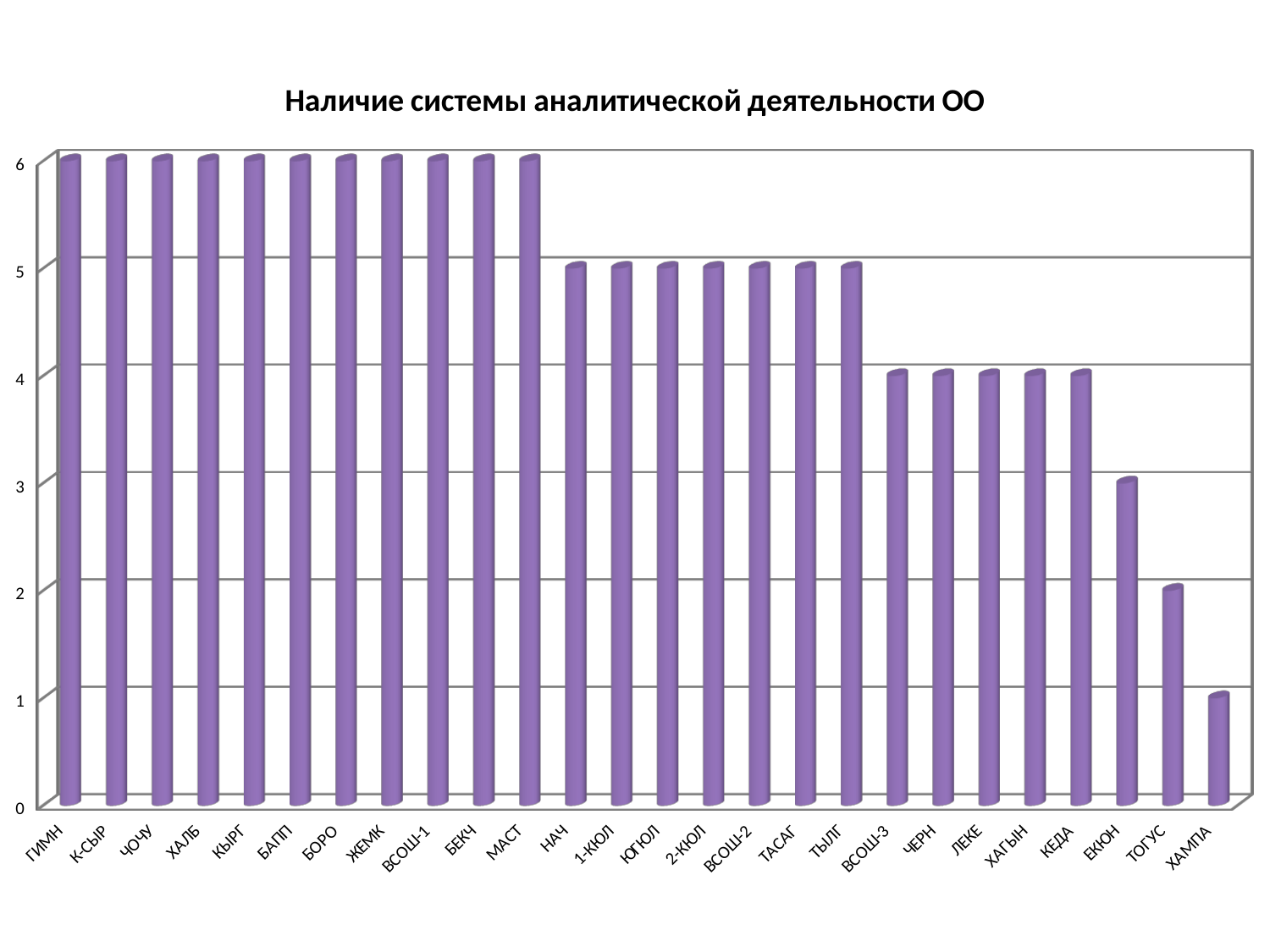
How many categories are shown on the x axis? 26 What is the value for ТОГУС? 2 What is the value for ЧЕРН? 4 Which is larger, the value for НАЧ or the value for КЕДА? НАЧ What is the title of the chart? Наличие системы аналитической деятельности ОО Do the values generally rise or fall from left to right along the x axis? fall What type of chart is shown on the slide? bar chart What is the value for ТЫЛГ? 5 What is the value for ХАМПА? 1 What is the value for ЕКЮН? 3 What is the difference between the values for ГИМН and ХАМПА? 5 Which category has the lowest value? ХАМПА